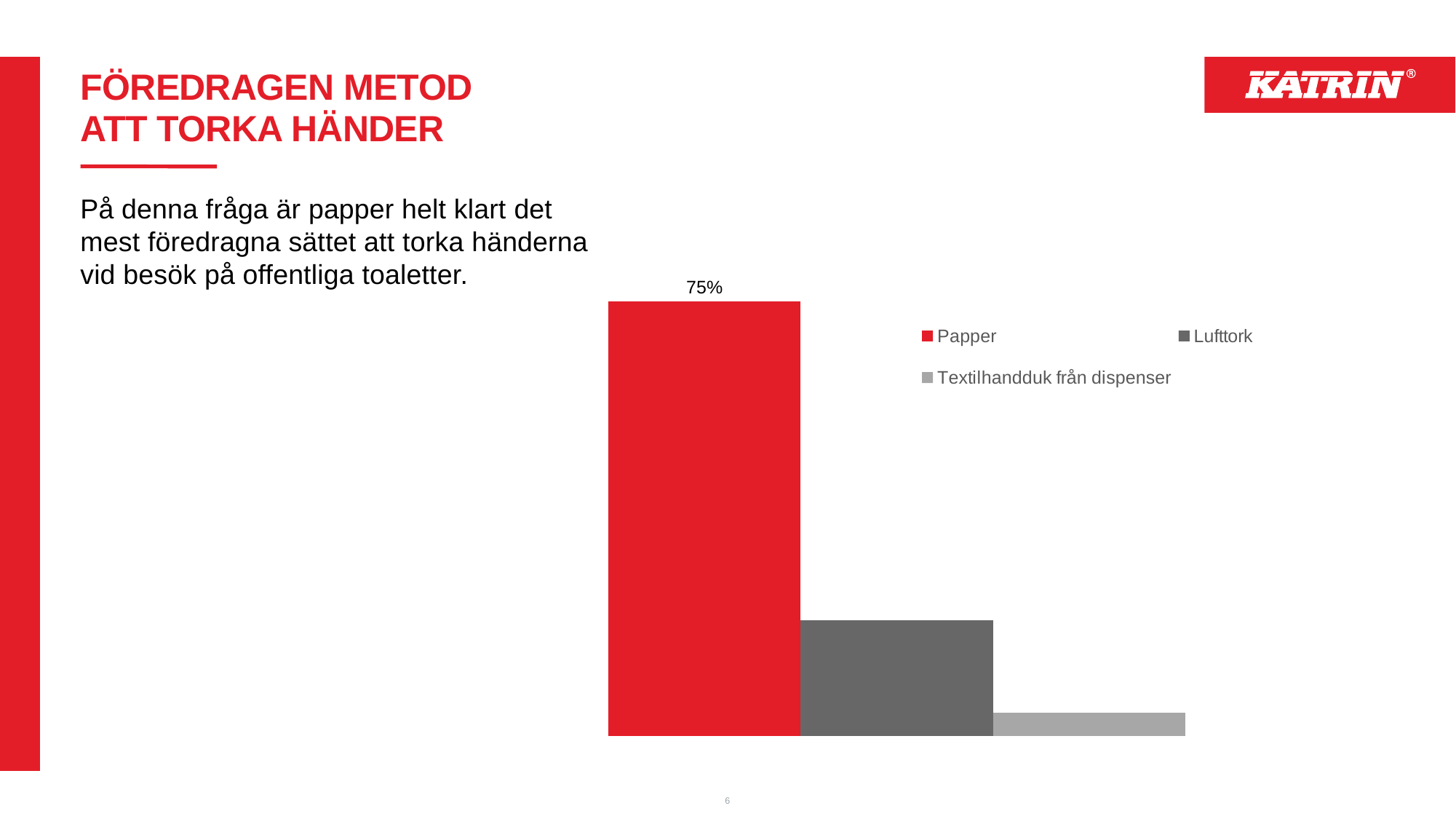
Which legend entry is shown in light grey? Textilhandduk från dispenser What kind of chart is shown on the slide? Bar chart What value is shown for Papper in the chart? 75% What colour is the bar for Papper? Red Which series has the highest value in the chart? Papper Which series has the lowest value in the chart? Textilhandduk från dispenser How many bars are plotted in the chart? 3 How many series does the legend list? 3 Which is larger, the value for Lufttork or the value for Textilhandduk från dispenser? Lufttork Which is larger, the value for Papper or the value for Lufttork? Papper